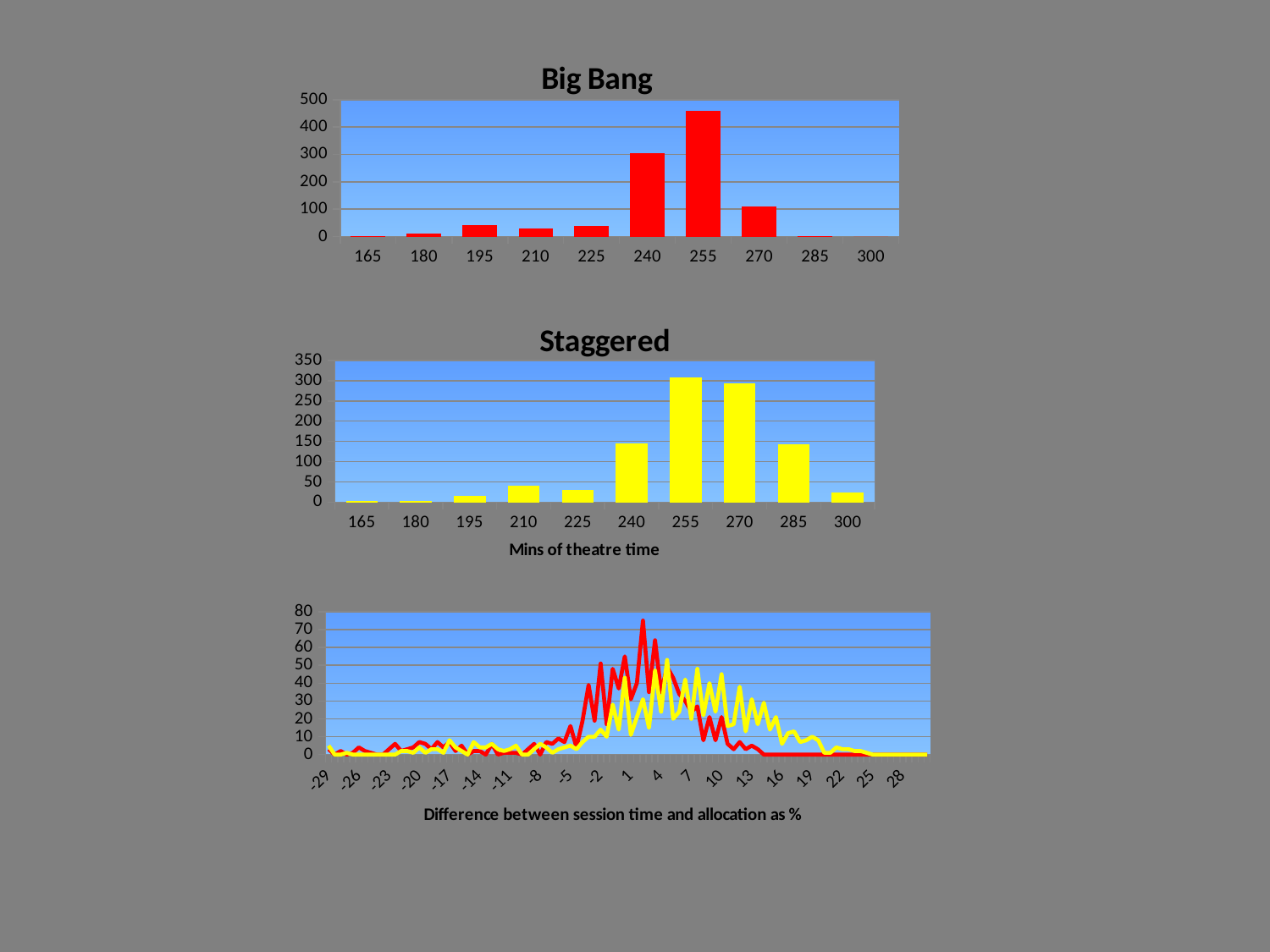
In the "Big Bang" chart, is the value for 255 greater or less than 400? greater In the "Staggered" chart, which is larger, the value for 285 or the value for 300? 285 How many categories are shown on the x axis of the "Staggered" chart? 10 In the "Staggered" chart, is the value for 255 greater or less than 250? greater What kind of chart is the "Big Bang" chart? bar chart What kind of chart is the bottom chart on the slide? line chart In the "Staggered" chart, is the value for 240 greater or less than 200? less What is the x-axis title of the "Staggered" chart? Mins of theatre time How many categories are shown on the x axis of the "Big Bang" chart? 10 In the "Big Bang" chart, which category has the highest bar? 255 In the "Big Bang" chart, which is larger, the value for 240 or the value for 270? 240